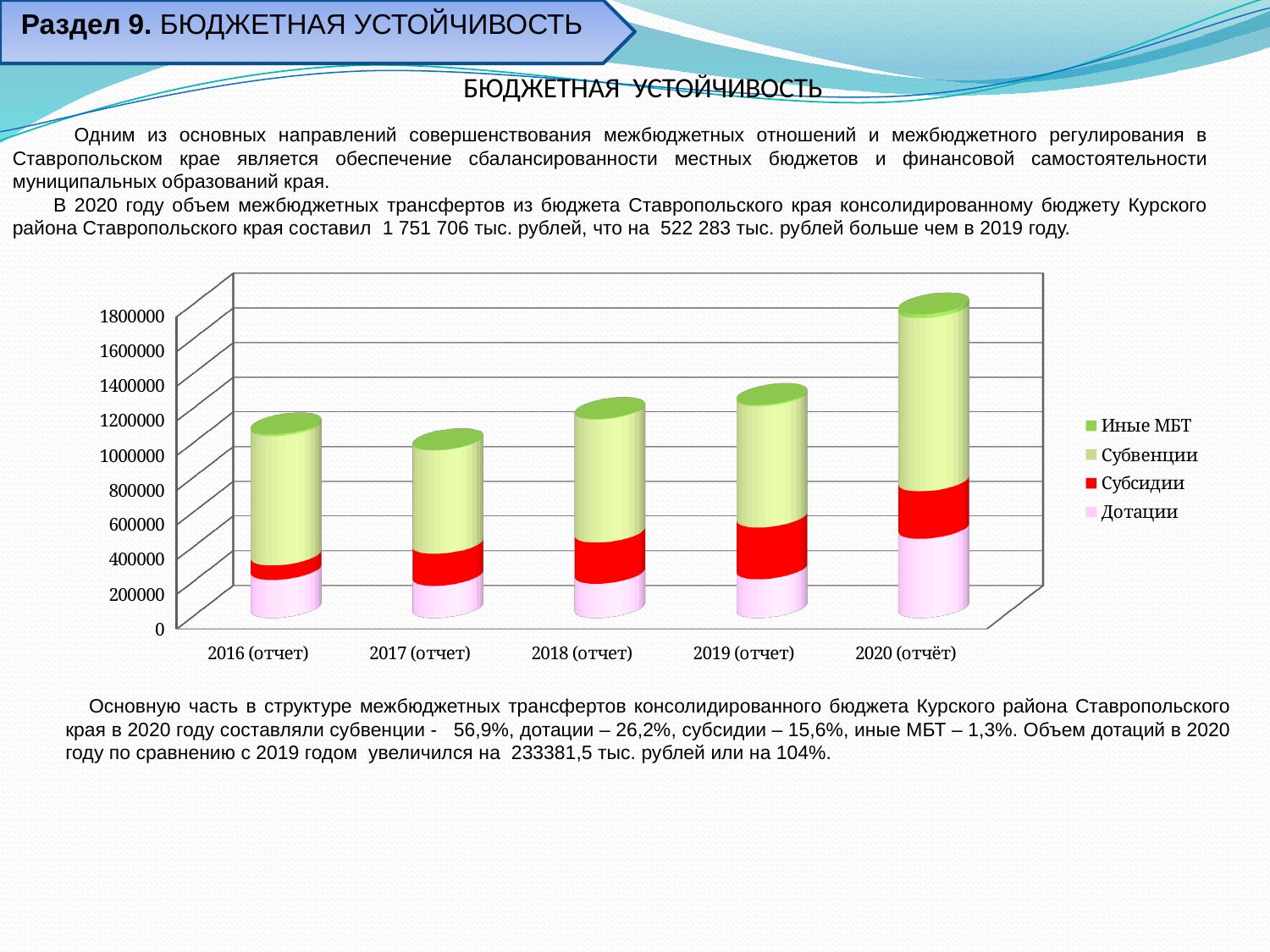
Which stacked bar is taller, 2018 (отчет) or 2017 (отчет)? 2018 (отчет) Is the total of the stacked bar for 2017 (отчет) greater or less than 1200000? less What kind of chart is shown on the slide? stacked bar chart Which year has the tallest stacked bar in the chart? 2020 (отчёт) How many years (categories) are shown on the x axis of the chart? 5 How many series does the chart legend list? 4 Which year has the shortest stacked bar in the chart? 2017 (отчет) Do the stacked bar totals rise or fall from 2017 (отчет) to 2020 (отчёт)? rise Which series is shown at the bottom of each stacked bar in the chart? Дотации Is the total of the stacked bar for 2019 (отчет) greater or less than 1000000? greater Is the total of the stacked bar for 2020 (отчёт) greater or less than 1600000? greater Which stacked bar is taller, 2020 (отчёт) or 2019 (отчет)? 2020 (отчёт)